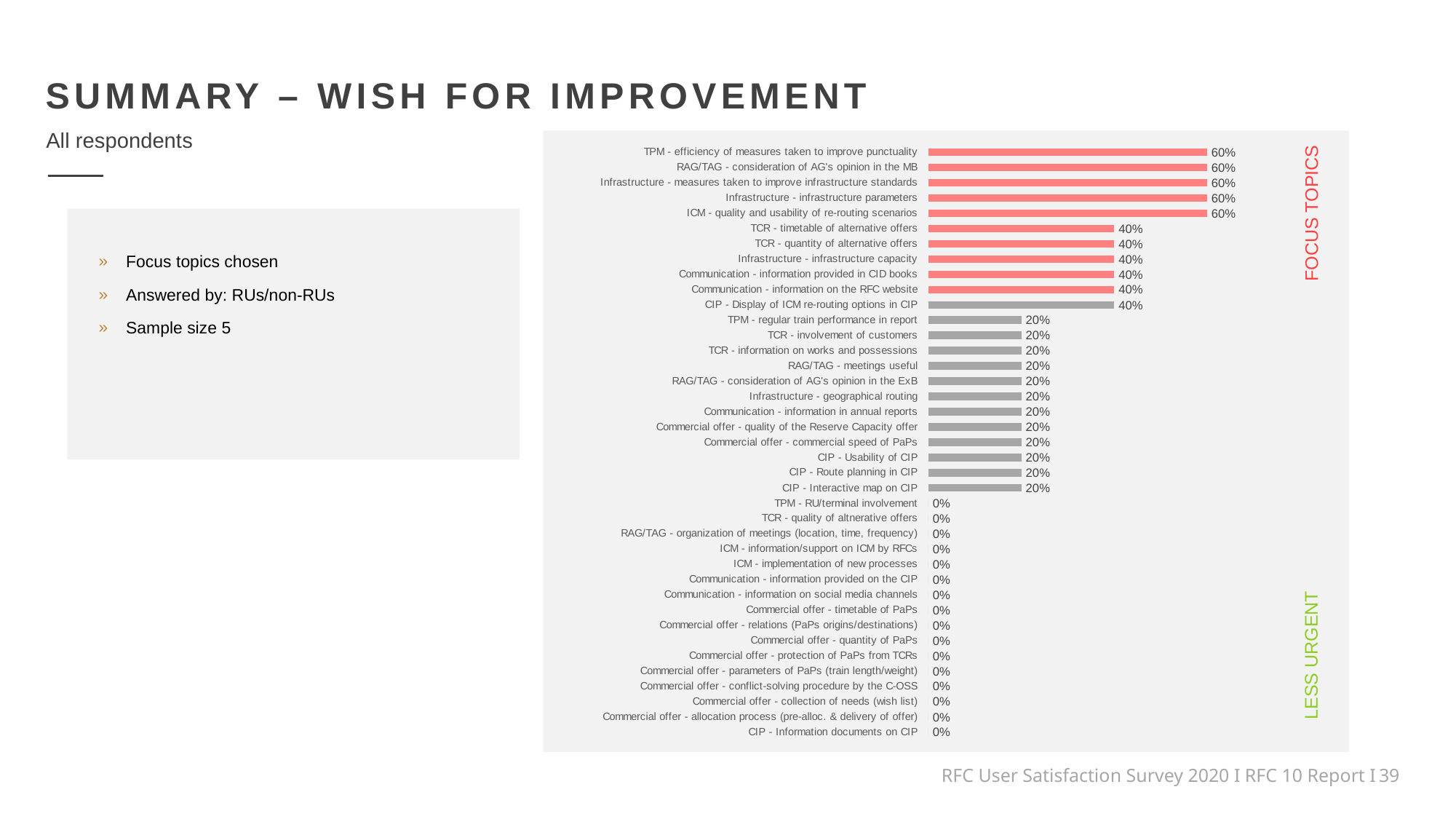
What is the value for "CIP - Display of ICM re-routing options in CIP"? 40% What is the value for "Infrastructure - geographical routing"? 20% What label appears in red on the right side of the chart next to the top bars? FOCUS TOPICS What kind of chart is shown on the slide? Bar chart How many categories have a value of 40%? 6 What is the difference between the value for "ICM - quality and usability of re-routing scenarios" and the value for "TCR - timetable of alternative offers"? 20% What label appears in green on the right side of the chart next to the bottom bars? LESS URGENT How many categories have a value of 60%? 5 Which is larger, the value for "Infrastructure - infrastructure capacity" or the value for "TCR - involvement of customers"? Infrastructure - infrastructure capacity What is the highest value shown in the chart? 60% What is the value for "TPM - efficiency of measures taken to improve punctuality"? 60% What is the value for "CIP - Information documents on CIP"? 0%